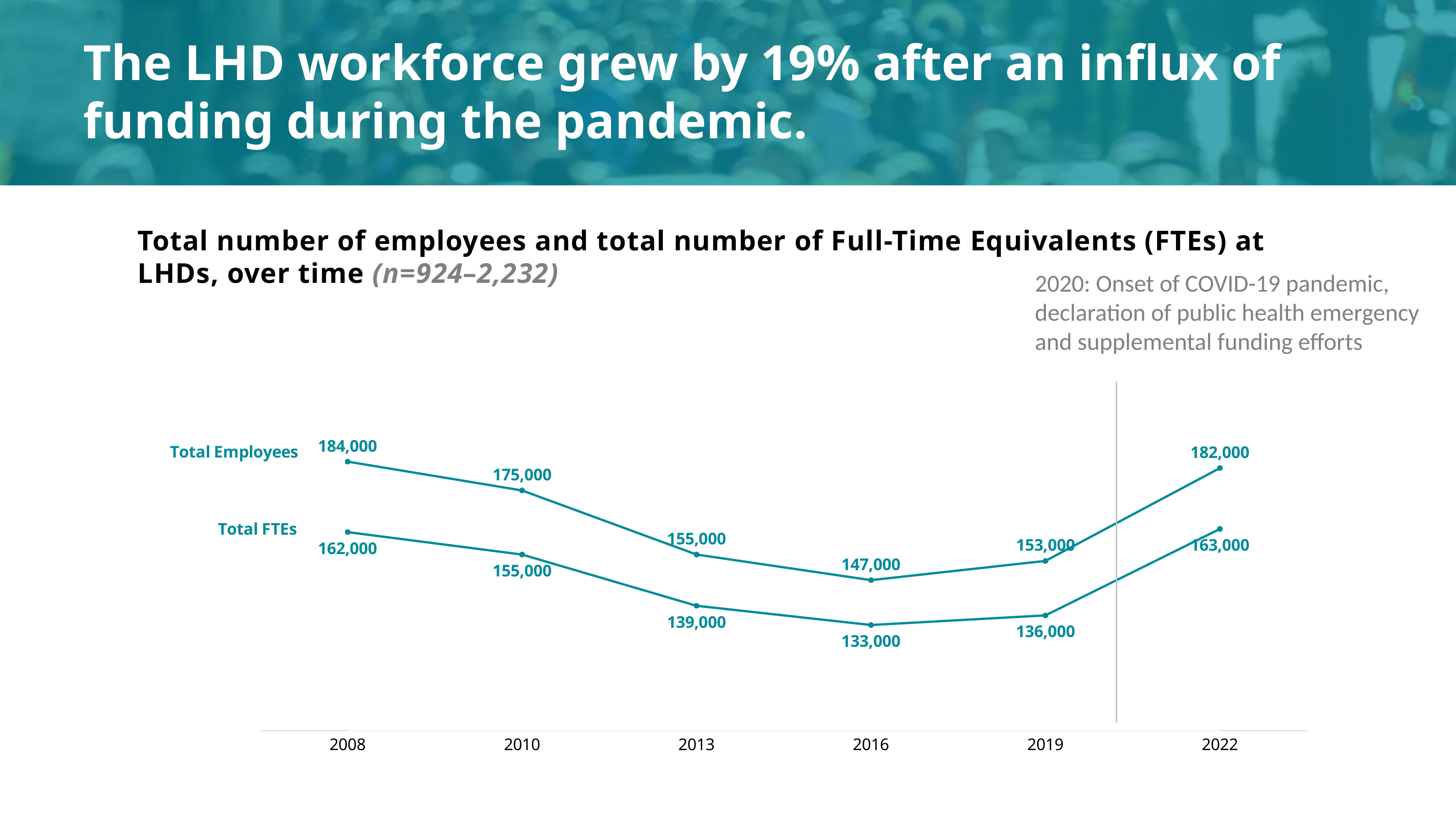
In which year was the total number of FTEs highest? 2022 What is the difference between total employees and total FTEs in 2022? 19,000 How many years are plotted on the x axis? 6 What was the total number of FTEs at LHDs in 2016? 133,000 What was the total number of FTEs in 2019? 136,000 By how much did the total number of employees change from 2019 to 2022? 29,000 How many series does the chart show? 2 Which is larger: total FTEs in 2008 or total FTEs in 2022? Total FTEs in 2022 What kind of chart is shown on the slide? Line chart In which year was the total number of employees lowest? 2016 What was the total number of employees in 2022? 182,000 What was the total number of employees at LHDs in 2008? 184,000